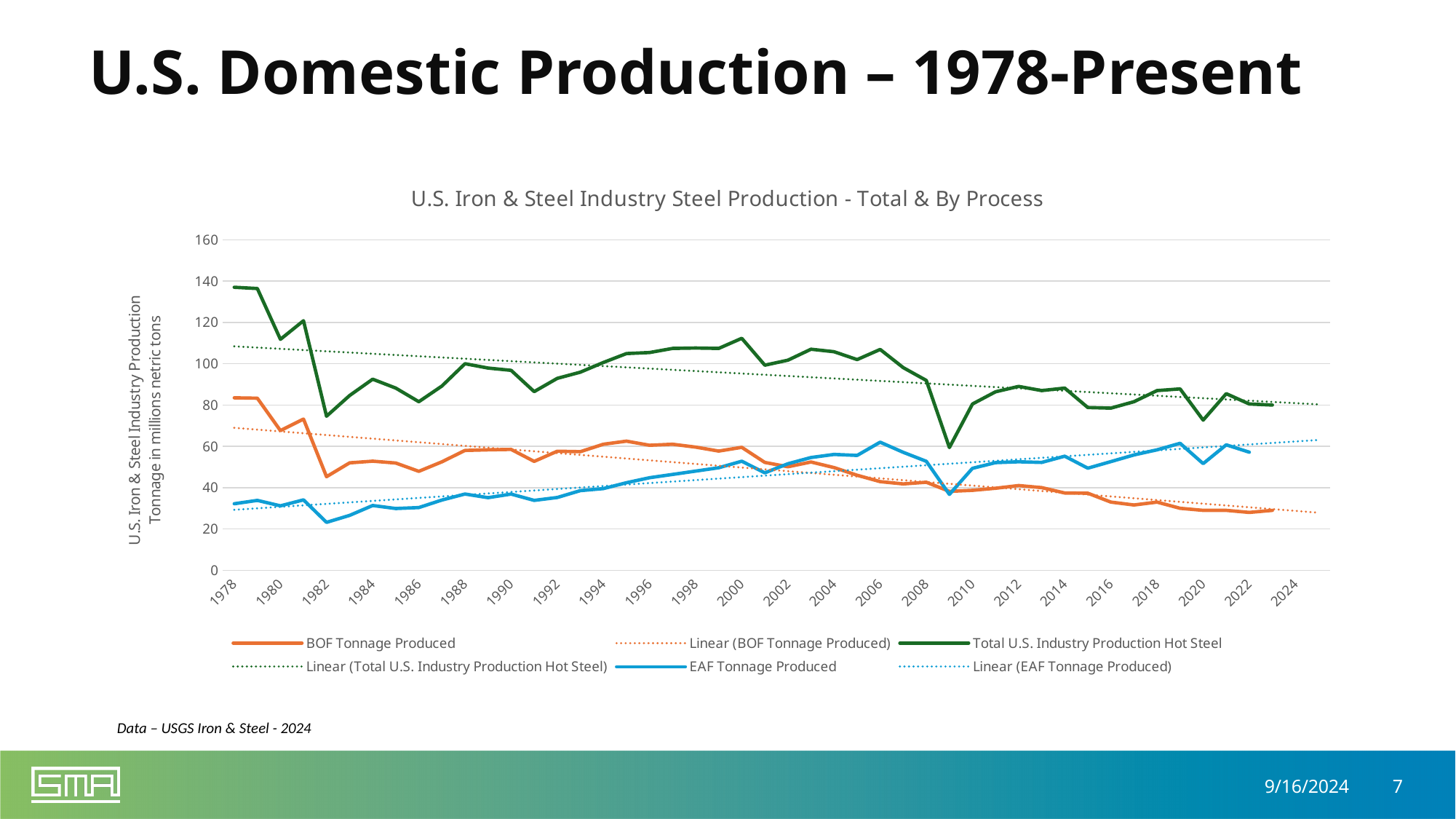
Is the value for BOF Tonnage Produced in 2023 greater or less than 40? less What is the title of the chart? U.S. Iron & Steel Industry Steel Production - Total & By Process Is the value for EAF Tonnage Produced in 1982 greater or less than 40? less How many series does the legend list? 6 Is the value for Total U.S. Industry Production Hot Steel in 2009 greater or less than 80? less In which year is Total U.S. Industry Production Hot Steel at its lowest? 2009 What kind of chart is shown on the slide? Line chart Does EAF Tonnage Produced generally rise or fall from 1978 to the present? Rise What colour is the EAF Tonnage Produced line? Blue In 2022, which is larger: EAF Tonnage Produced or BOF Tonnage Produced? EAF Tonnage Produced